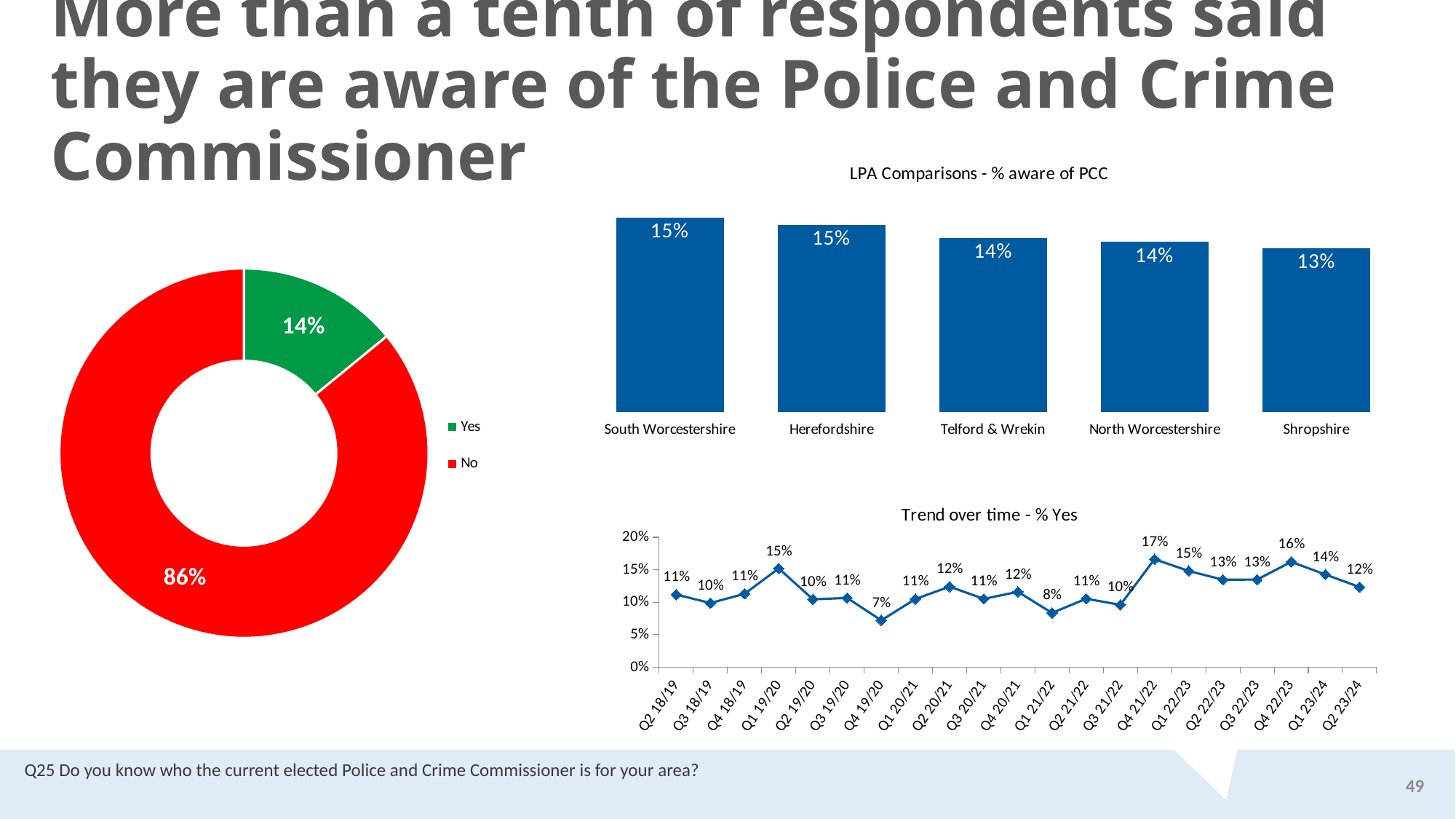
In the 'Trend over time - % Yes' chart, what is the value for Q4 21/22? 17% In the donut chart on the left, what percentage of respondents answered Yes? 14% In the 'Trend over time - % Yes' chart, which quarter has the lowest value? Q4 19/20 What kind of chart is 'LPA Comparisons - % aware of PCC'? Bar chart In the 'LPA Comparisons - % aware of PCC' chart, which LPA has the lowest value? Shropshire How many entries does the legend of the donut chart on the left list? 2 In the 'LPA Comparisons - % aware of PCC' chart, what is the difference between South Worcestershire and Shropshire? 2% In the 'Trend over time - % Yes' chart, what is the value for Q2 23/24? 12% In the donut chart on the left, what percentage of respondents answered No? 86% In the 'LPA Comparisons - % aware of PCC' chart, what is the value for Shropshire? 13% In the 'LPA Comparisons - % aware of PCC' chart, what is the value for Telford & Wrekin? 14% In the 'LPA Comparisons - % aware of PCC' chart, how many LPAs are shown? 5